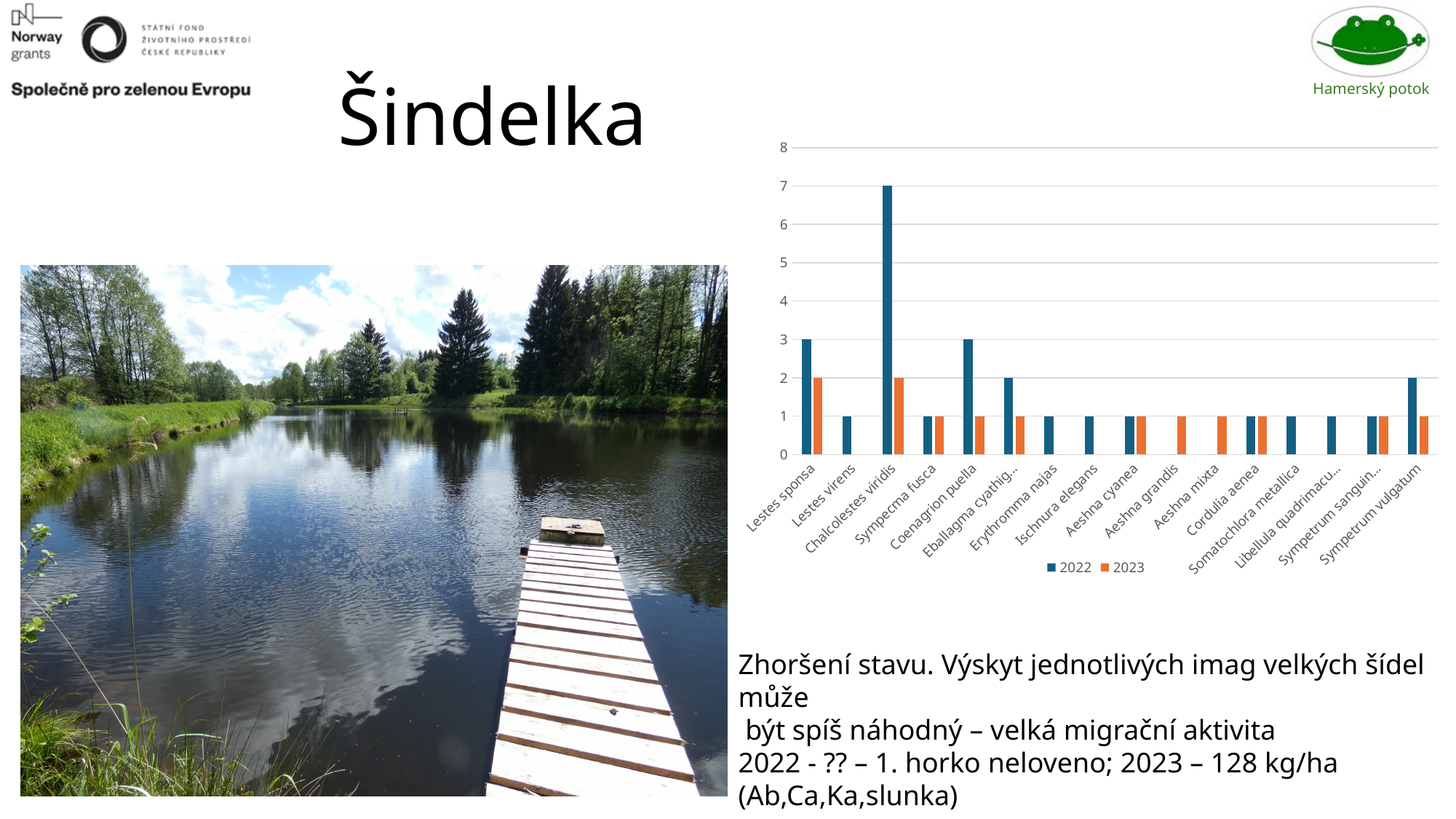
What is the difference between the 2022 and 2023 values for Chalcolestes viridis? 5 What is the 2022 value for Coenagrion puella? 3 What is the 2022 value for Chalcolestes viridis? 7 What is the 2023 value for Aeshna grandis? 1 What is the 2022 value for Sympetrum vulgatum? 2 What type of chart is shown on the slide? bar chart Is the 2022 value for Chalcolestes viridis greater or less than 5? greater What are the two series names shown in the chart legend? 2022 and 2023 Which is larger for Lestes sponsa, the 2022 value or the 2023 value? 2022 Which category has the highest value for the 2022 series? Chalcolestes viridis How many series does the chart legend list? 2 What is the 2023 value for Lestes sponsa? 2